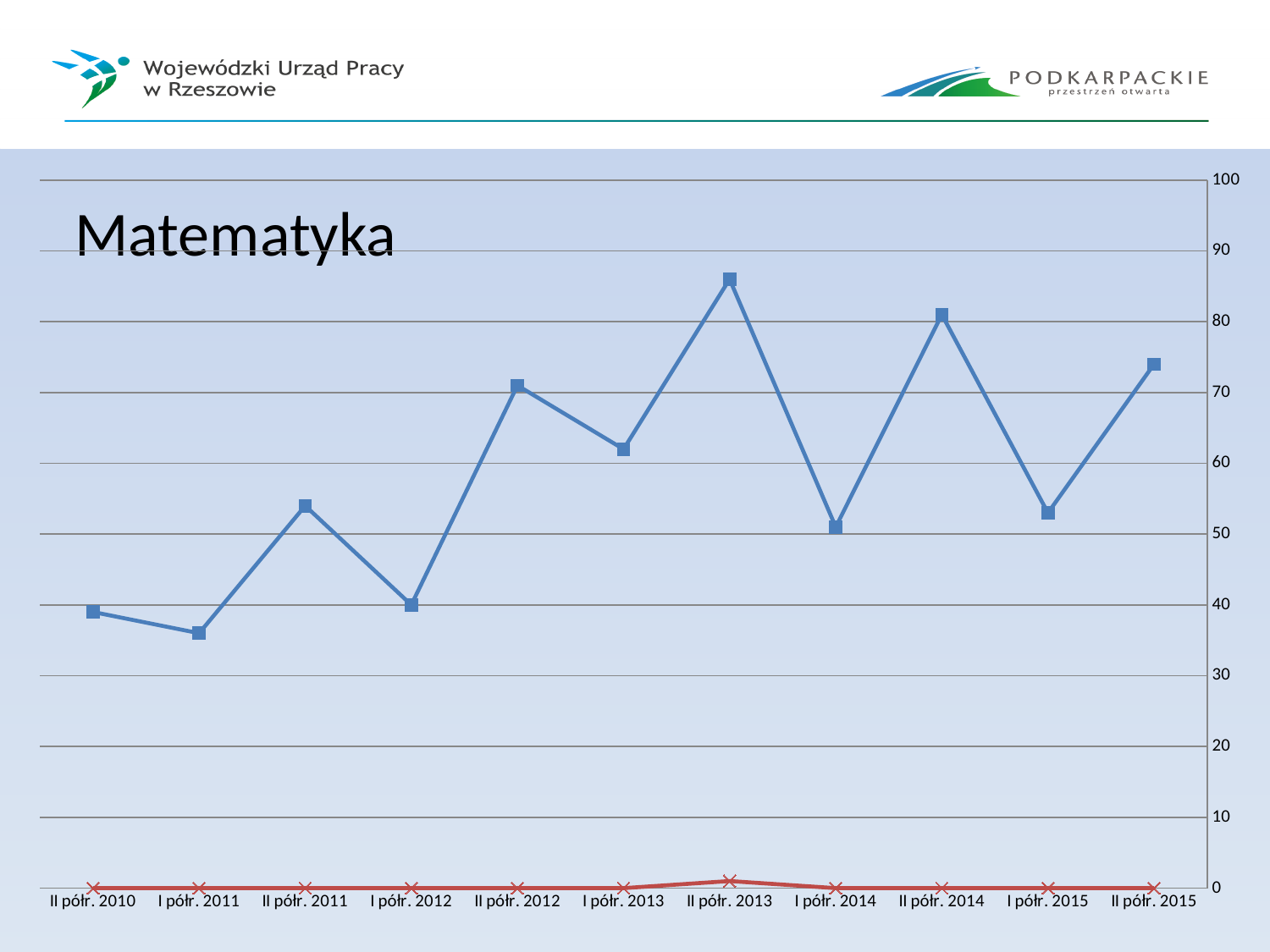
In which category does the blue line reach its highest value? II półr. 2013 Which has the larger value on the blue line: II półr. 2011 or I półr. 2012? II półr. 2011 Is the value of the red line for II półr. 2010 greater or less than 10? less Is the value of the blue line for II półr. 2013 greater or less than 80? greater How many categories are shown on the x axis? 11 Does the blue line rise or fall from II półr. 2010 to I półr. 2011? fall Which has the larger value on the blue line: II półr. 2012 or I półr. 2013? II półr. 2012 Is the value of the blue line for I półr. 2014 greater or less than 60? less What kind of chart is shown on the slide? line chart What is the title of the chart? Matematyka